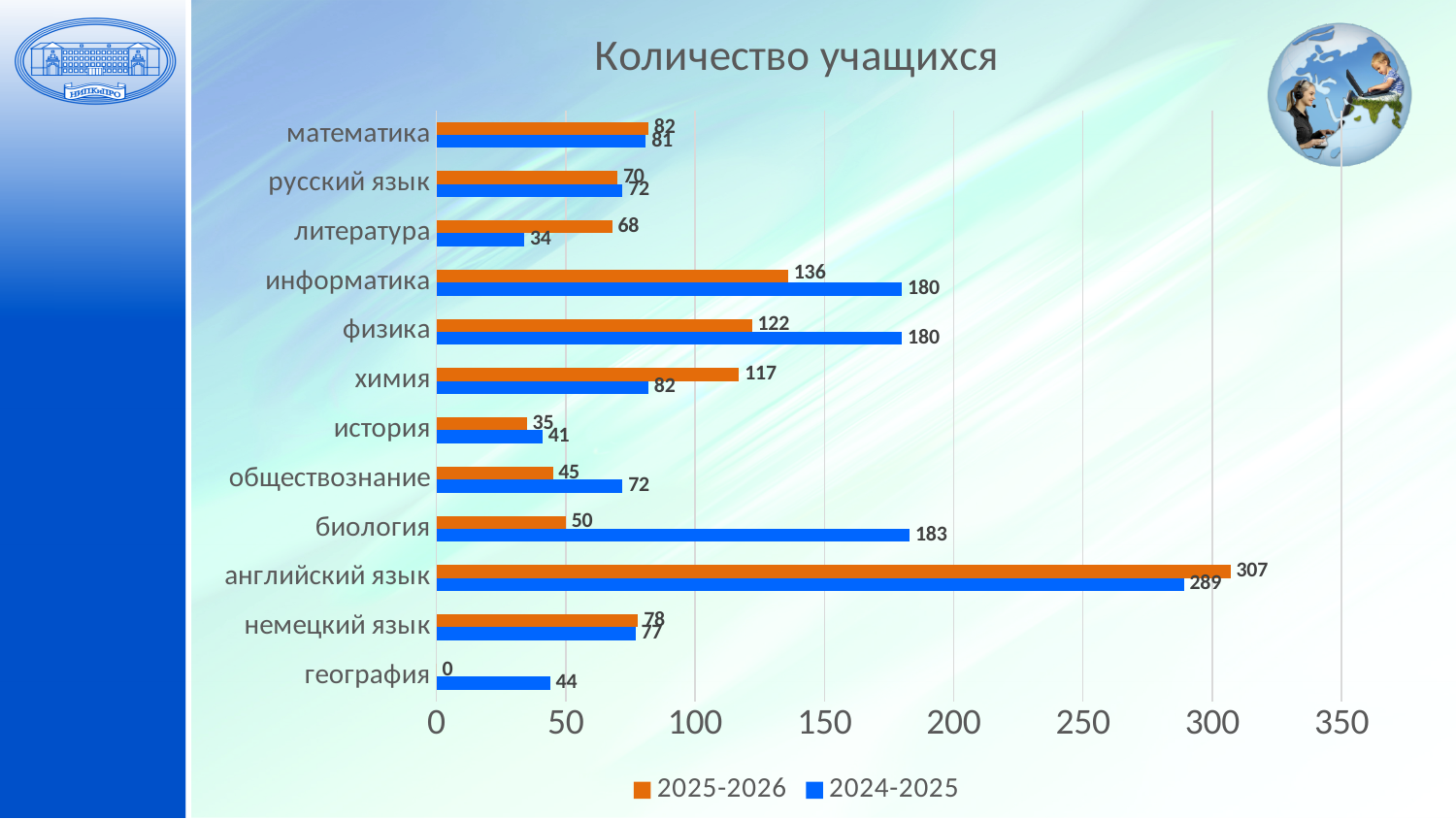
How many subject categories are shown on the chart? 12 Which colour represents the 2024-2025 series? blue What is the value for информатика in the 2024-2025 series? 180 What is the title of the chart? Количество учащихся What is the value for география in the 2024-2025 series? 44 How many series does the legend list? 2 What is the difference between the 2024-2025 and 2025-2026 values for биология? 133 Which subject has the lowest value in the 2025-2026 series? география What is the value for биология in the 2025-2026 series? 50 What type of chart is shown on the slide? bar chart Which subject has the highest value in the 2025-2026 series? английский язык For химия, which series has the larger value, 2025-2026 or 2024-2025? 2025-2026